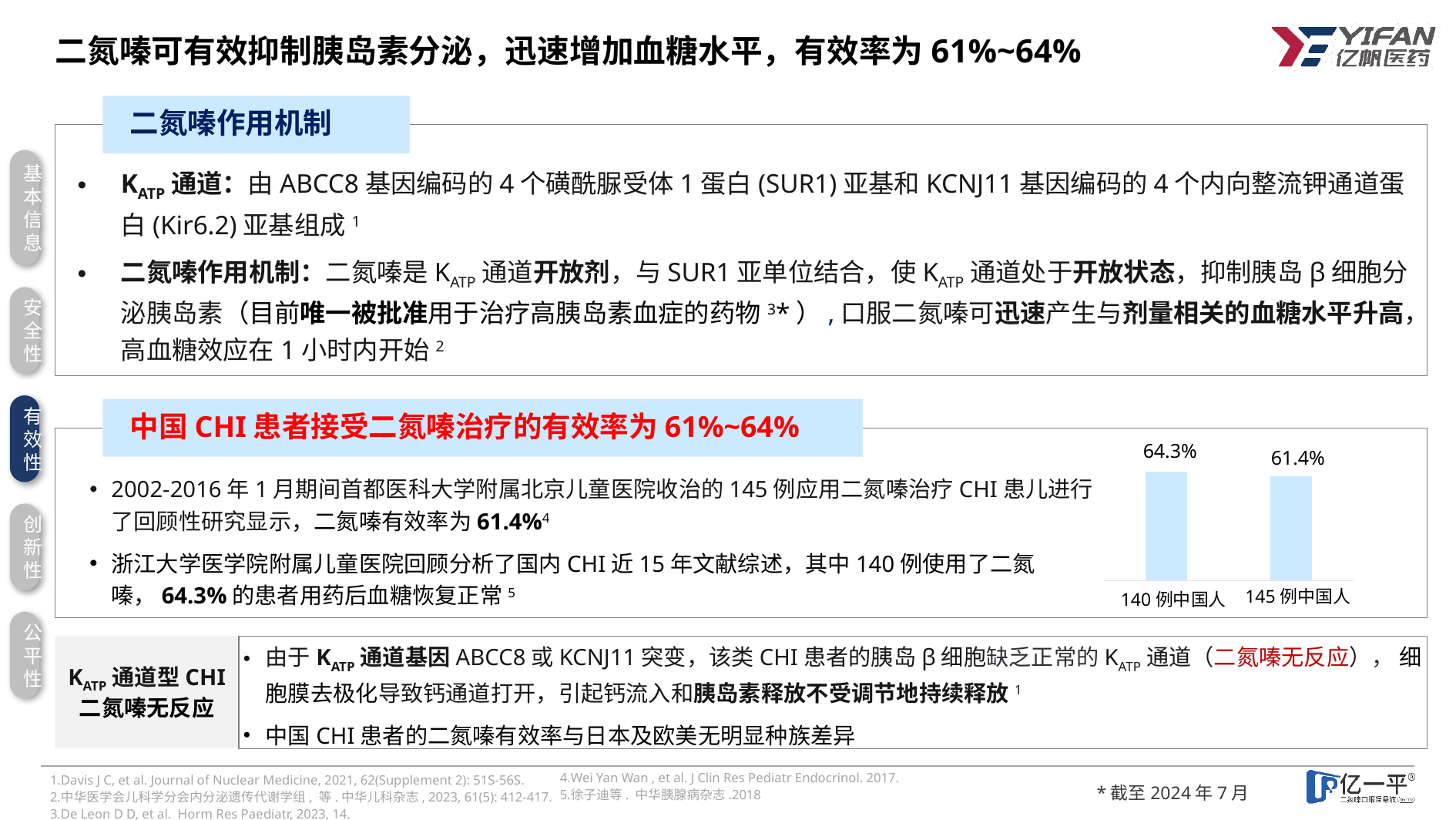
Which category in the bar chart has the lower value? 145 例中国人 Which category in the bar chart has the higher value? 140 例中国人 What is the label of the left bar in the chart? 140 例中国人 What kind of chart is shown on the right side of the slide? bar chart What is the value shown for 145 例中国人 in the bar chart? 61.4% What is the difference between the values for 140 例中国人 and 145 例中国人 in the bar chart? 2.9% How many bars are plotted in the chart? 2 Is the value for 140 例中国人 larger or smaller than the value for 145 例中国人? larger Do the values in the bar chart rise or fall from left to right? fall What colour are the bars in the chart? light blue What is the value shown for 140 例中国人 in the bar chart? 64.3%